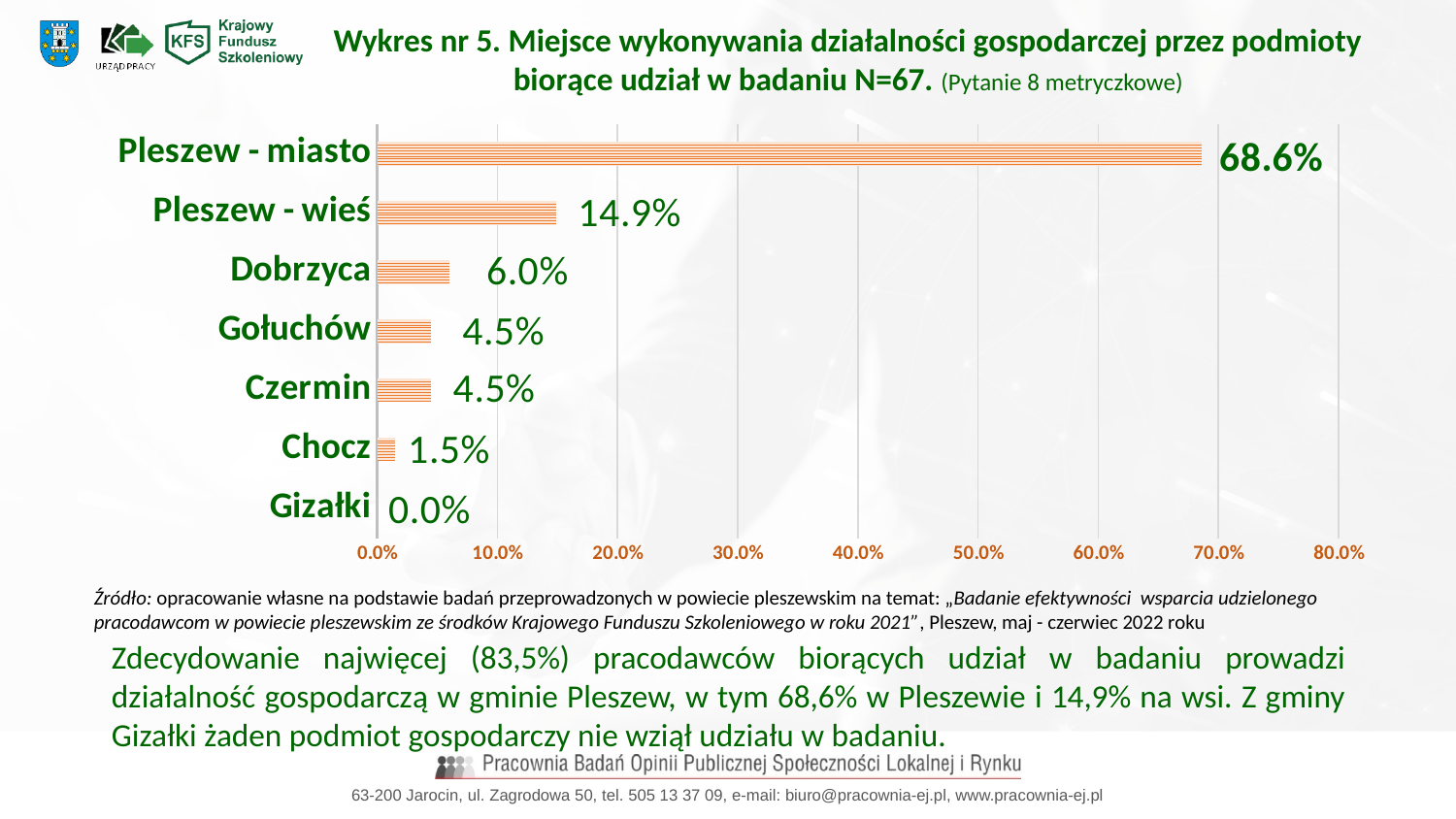
What is the value for Pleszew - miasto? 68.6% What kind of chart is shown on the slide? bar chart How many categories are shown on the chart? 7 Is the value for Pleszew - miasto greater or less than 60.0%? greater Which category has the highest value? Pleszew - miasto What is the value for Dobrzyca? 6.0% What is the value for Pleszew - wieś? 14.9% Which category has the lowest value? Gizałki Which is larger, the value for Dobrzyca or the value for Gołuchów? Dobrzyca What is the value for Chocz? 1.5% What is the difference between the values for Pleszew - miasto and Pleszew - wieś? 53.7% What is the value of N stated in the chart title? 67